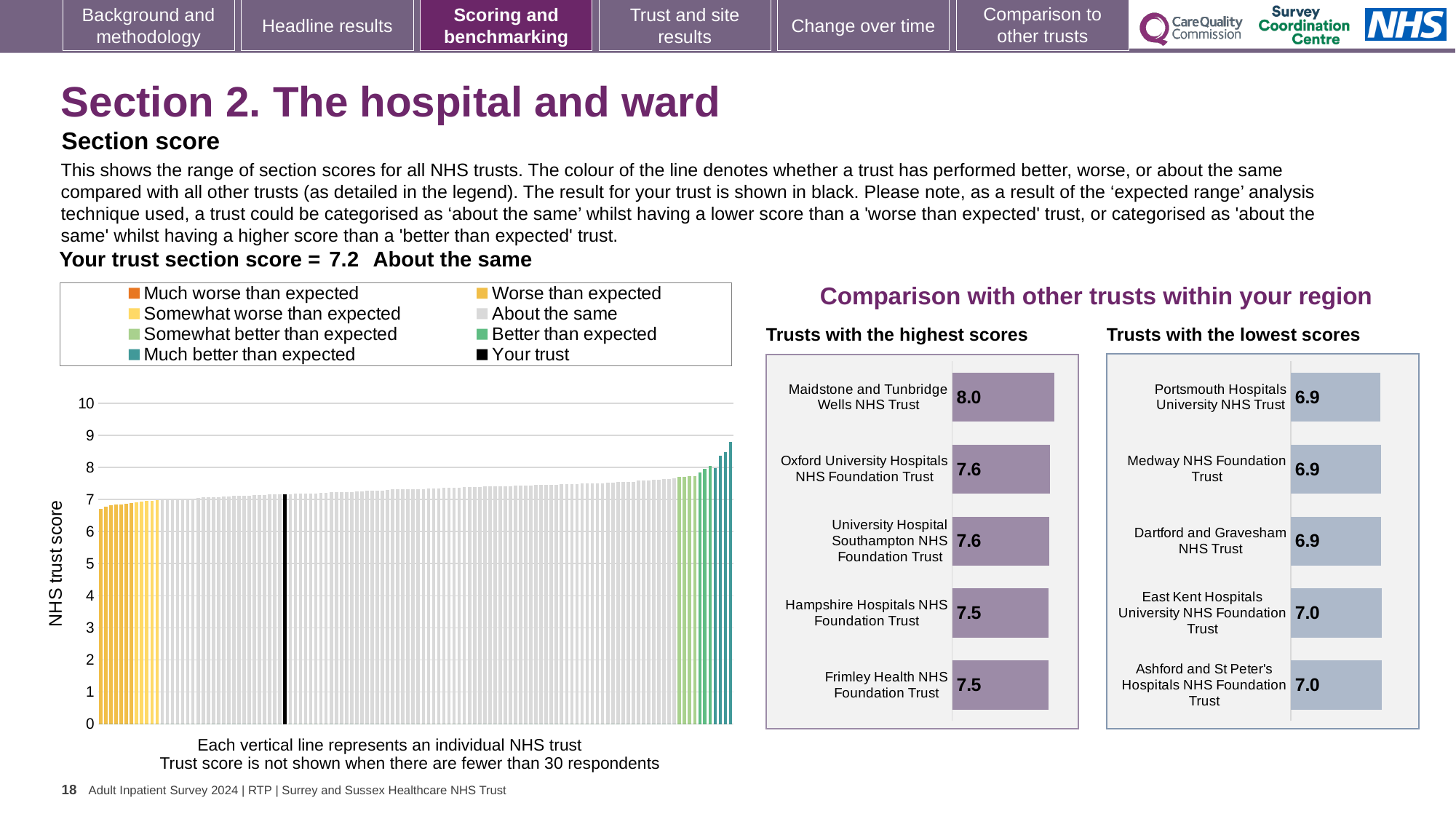
In the 'Trusts with the lowest scores' chart, what is the score for Portsmouth Hospitals University NHS Trust? 6.9 What kind of chart is the NHS trust score chart on the left of the slide? Bar chart In the NHS trust score chart on the left, do the values rise or fall from left to right along the x axis? Rise In the 'Trusts with the highest scores' chart, what is the score for Maidstone and Tunbridge Wells NHS Trust? 8.0 In the 'Trusts with the highest scores' chart, which trust has the highest score? Maidstone and Tunbridge Wells NHS Trust In the 'Trusts with the lowest scores' chart, what is the score for East Kent Hospitals University NHS Foundation Trust? 7.0 Which is larger: the score for Maidstone and Tunbridge Wells NHS Trust in the highest scores chart or the score for Portsmouth Hospitals University NHS Trust in the lowest scores chart? Maidstone and Tunbridge Wells NHS Trust How many entries does the legend of the NHS trust score chart on the left list? 8 In the 'Trusts with the highest scores' chart, what is the score for Hampshire Hospitals NHS Foundation Trust? 7.5 In the NHS trust score chart on the left, is the value of the black bar (your trust) greater or less than 5? greater In the 'Trusts with the highest scores' chart, what is the difference between the scores of Maidstone and Tunbridge Wells NHS Trust and Frimley Health NHS Foundation Trust? 0.5 How many trusts are shown in the 'Trusts with the lowest scores' chart? 5